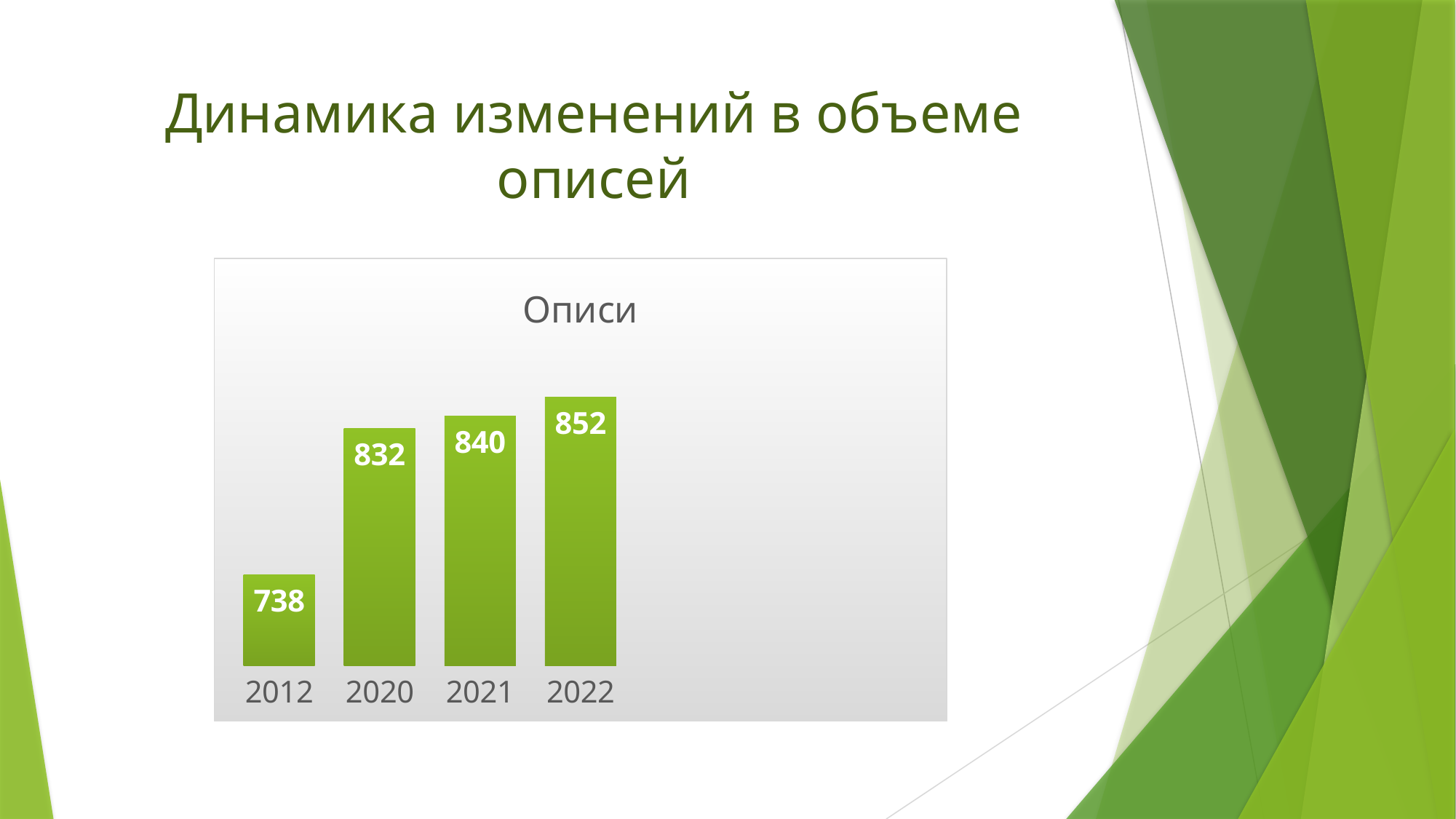
Which year has the highest value? 2022 What is the value for 2022? 852 What is the difference between the values for 2022 and 2012? 114 What kind of chart is this? bar chart What is the value for 2020? 832 How many years are shown on the chart? 4 Which is larger, the value for 2020 or the value for 2012? 2020 Do the values rise or fall from 2012 to 2022? rise What is the value for 2012? 738 What is the value for 2021? 840 Which year has the lowest value? 2012 What is the difference between the values for 2021 and 2020? 8